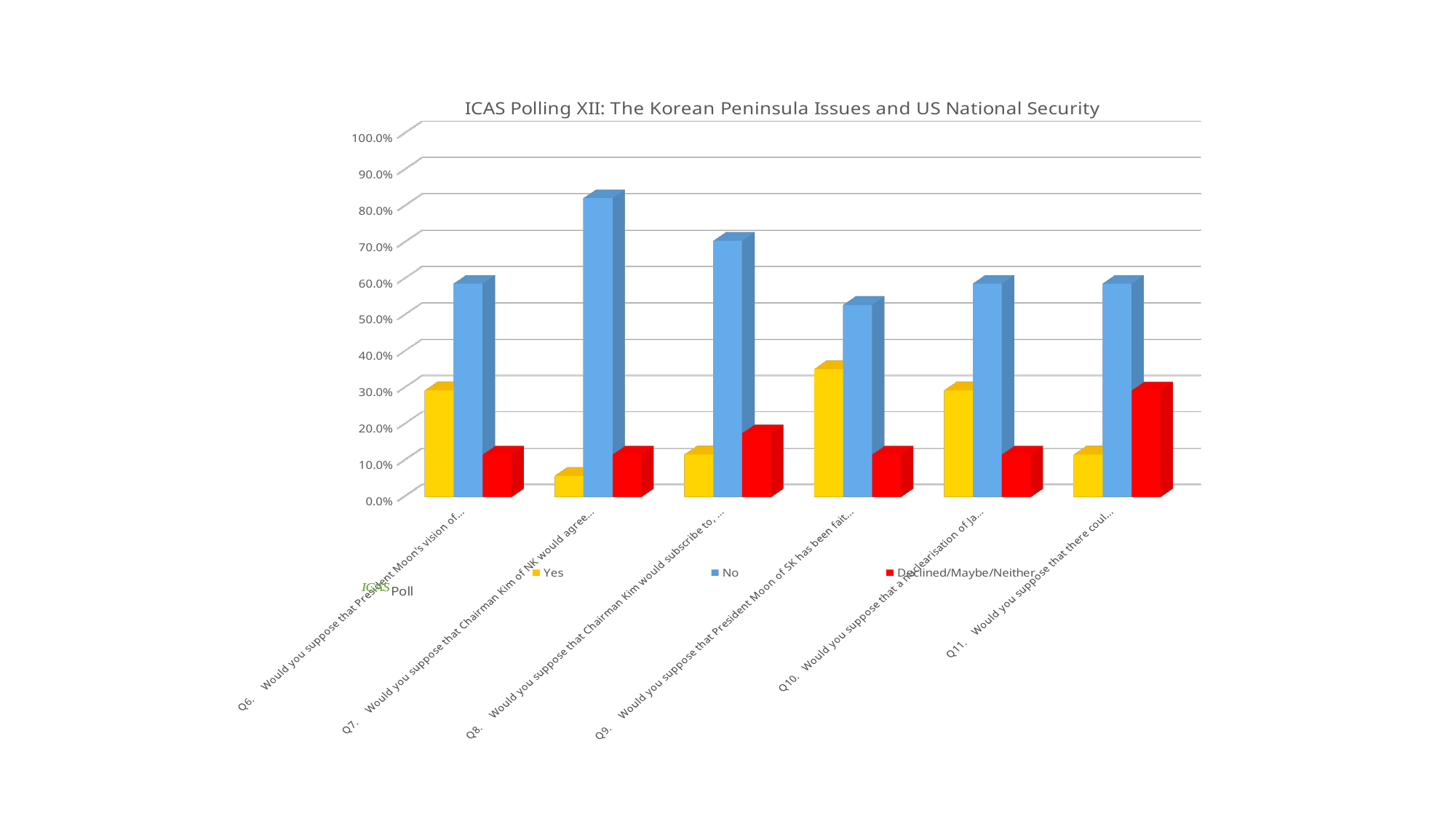
Is the 'No' value for Q8 greater or less than 60%? greater What kind of chart is shown on the slide? Bar chart Which is larger, the 'No' value for Q7 or the 'No' value for Q9? Q7 Is the 'Declined/Maybe/Neither' value for Q11 greater or less than 20%? greater What is the title of the chart? ICAS Polling XII: The Korean Peninsula Issues and US National Security For which question is the 'Yes' bar the lowest? Q7 Which series is shown in red in the legend? Declined/Maybe/Neither How many series does the legend list? 3 For which question is the 'No' bar the highest? Q7 Is the 'Yes' value for Q7 greater or less than 10%? less How many question categories are plotted on the x axis? 6